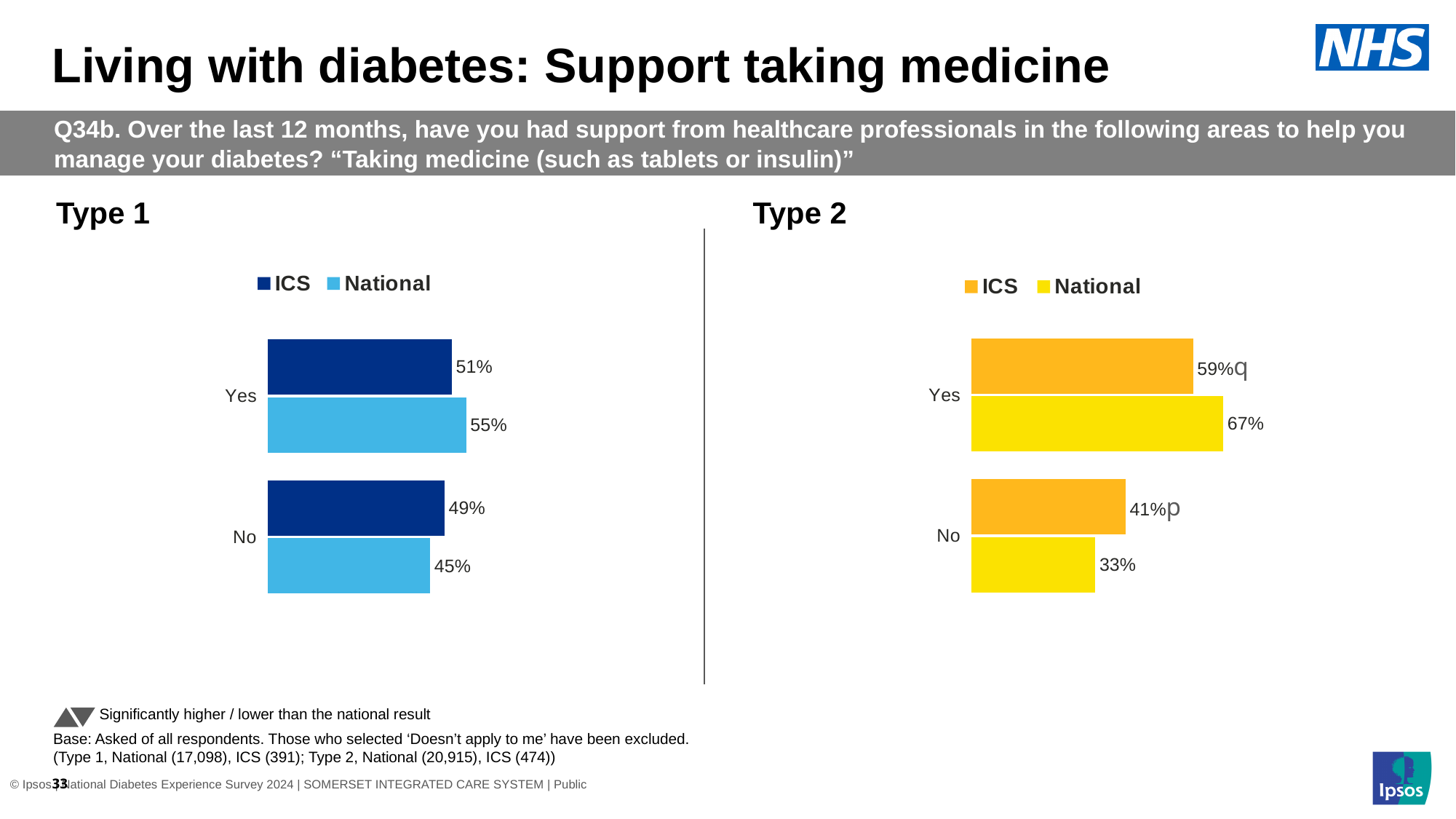
In the Type 1 chart, what is the difference between the ICS and National values for No? 4 percentage points In the Type 2 chart, what is the National value for Yes? 67% In the Type 1 chart, which is larger for Yes: ICS or National? National How many categories are shown on the Type 1 chart? 2 What kind of chart is the Type 2 chart? Bar chart In the Type 2 chart, which is larger for No: ICS or National? ICS In the Type 1 chart, what is the National value for No? 45% In the Type 2 chart, which series has the highest value for Yes? National In the Type 1 chart, what is the ICS value for Yes? 51% In the Type 2 chart, what is the difference between the National and ICS values for Yes? 8 percentage points In the Type 2 chart, what is the ICS value for No? 41% How many series does the legend of the Type 1 chart list? 2